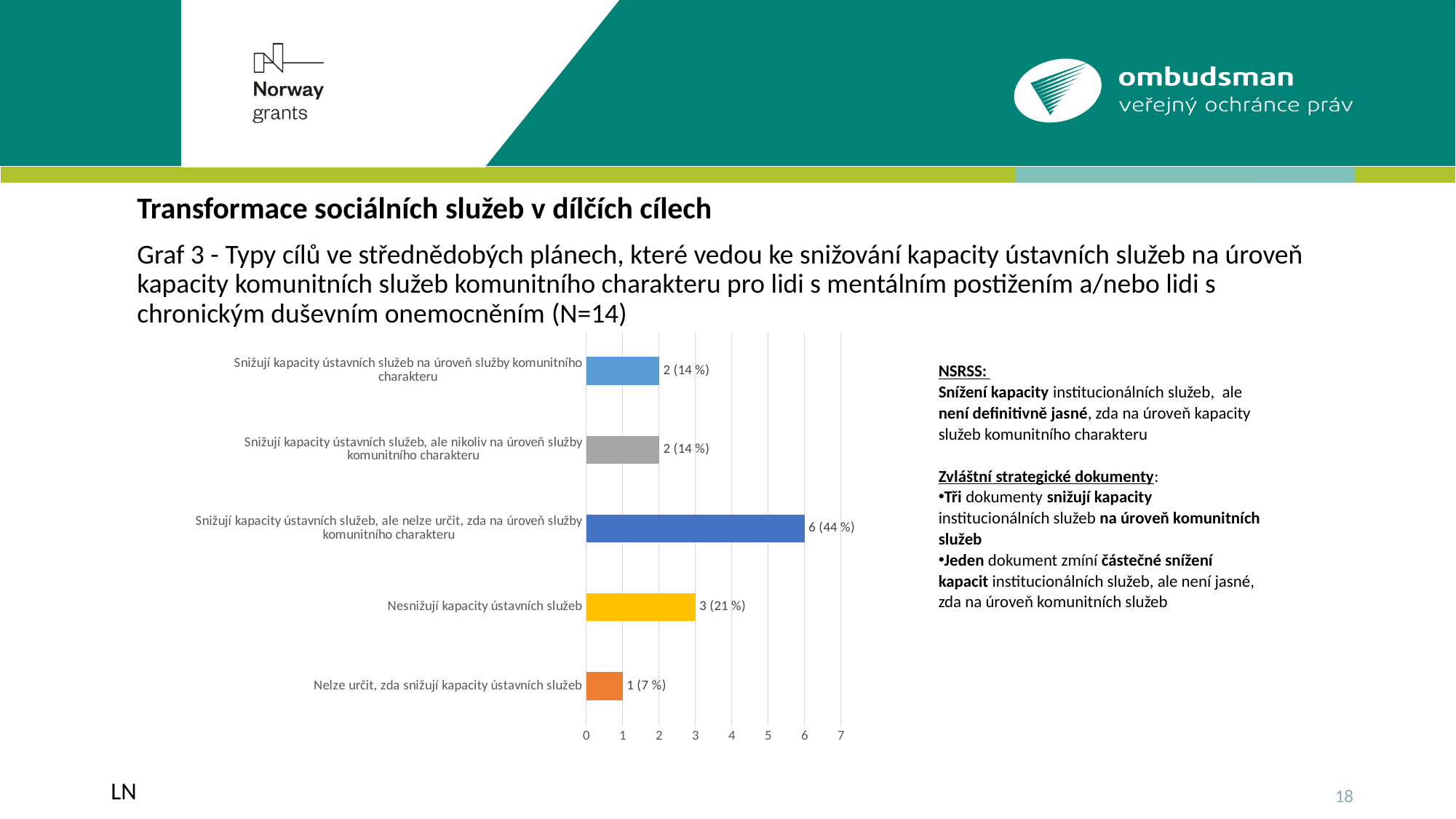
What is the highest value shown on the chart's horizontal axis? 7 Is the value for "Snižují kapacity ústavních služeb, ale nelze určit, zda na úroveň služby komunitního charakteru" greater or less than 5? greater What kind of chart is shown on the slide? bar chart What is the data label on the bar for "Snižují kapacity ústavních služeb, ale nelze určit, zda na úroveň služby komunitního charakteru"? 6 (44 %) How many categories are shown in the chart? 5 Which is larger: the value for "Nesnižují kapacity ústavních služeb" or the value for "Snižují kapacity ústavních služeb, ale nikoliv na úroveň služby komunitního charakteru"? Nesnižují kapacity ústavních služeb Which category has the highest value in the chart? Snižují kapacity ústavních služeb, ale nelze určit, zda na úroveň služby komunitního charakteru What is the data label on the bar for "Nesnižují kapacity ústavních služeb"? 3 (21 %) Which category has the lowest value in the chart? Nelze určit, zda snižují kapacity ústavních služeb What is the data label on the bar for "Nelze určit, zda snižují kapacity ústavních služeb"? 1 (7 %) What is the difference in count between "Snižují kapacity ústavních služeb, ale nelze určit, zda na úroveň služby komunitního charakteru" and "Nesnižují kapacity ústavních služeb"? 3 What is the data label on the bar for "Snižují kapacity ústavních služeb na úroveň služby komunitního charakteru"? 2 (14 %)